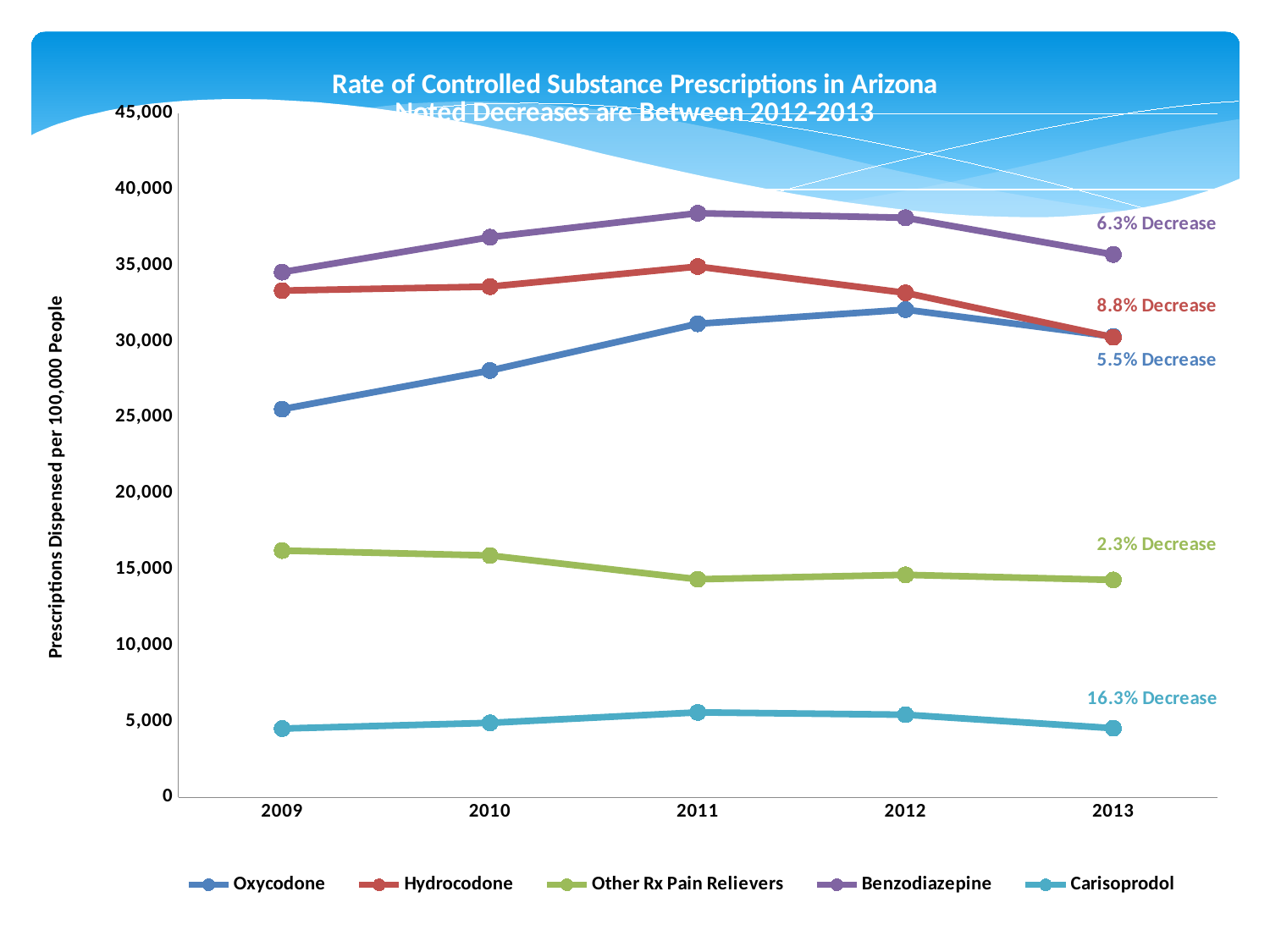
Which series has the highest value in 2013? Benzodiazepine In 2009, which is larger: the value for Benzodiazepine or the value for Hydrocodone? Benzodiazepine Which series has the lowest value in 2009? Carisoprodol How many years are shown on the x axis? 5 What percentage decrease is noted for Carisoprodol between 2012 and 2013? 16.3% Decrease What type of chart is shown on the slide? Line chart What is the title of the y axis? Prescriptions Dispensed per 100,000 People Is the value for Benzodiazepine in 2011 greater or less than 40,000? less Which series has the smallest noted percentage decrease between 2012 and 2013? Other Rx Pain Relievers How many series does the legend list? 5 What percentage decrease is noted for Hydrocodone between 2012 and 2013? 8.8% Decrease Is the value for Oxycodone in 2010 greater or less than 30,000? less